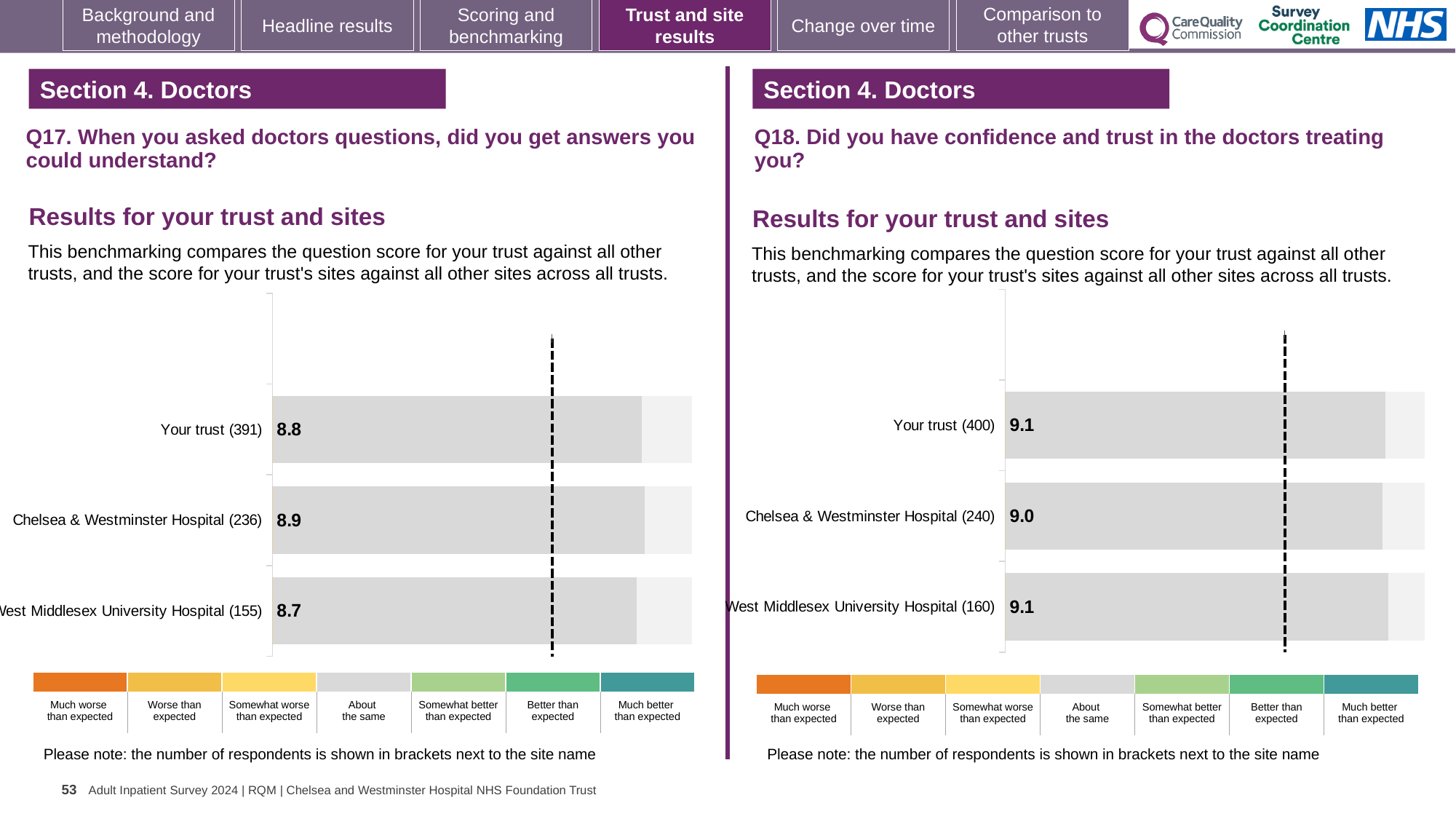
In the Q17 chart on the left, what is the score for Chelsea & Westminster Hospital (236)? 8.9 In the Q18 chart on the right, what is the score for Your trust (400)? 9.1 In the Q17 chart on the left, which site or trust has the lowest score? West Middlesex University Hospital (155) In the Q17 chart on the left, what is the difference between the scores for Chelsea & Westminster Hospital and West Middlesex University Hospital? 0.2 In the Q18 chart on the right, what is the score for Chelsea & Westminster Hospital (240)? 9.0 In the Q18 chart on the right, which is larger: the score for Your trust or the score for Chelsea & Westminster Hospital? Your trust What kind of chart is used in the Q17 chart on the left? Bar chart In the Q17 chart on the left, what is the score for Your trust (391)? 8.8 How many bars are plotted in the Q18 chart on the right? 3 In the Q17 chart on the left, what is the score for West Middlesex University Hospital (155)? 8.7 In the Q17 chart on the left, which site or trust has the highest score? Chelsea & Westminster Hospital (236) In the Q18 chart on the right, which site or trust has the lowest score? Chelsea & Westminster Hospital (240)